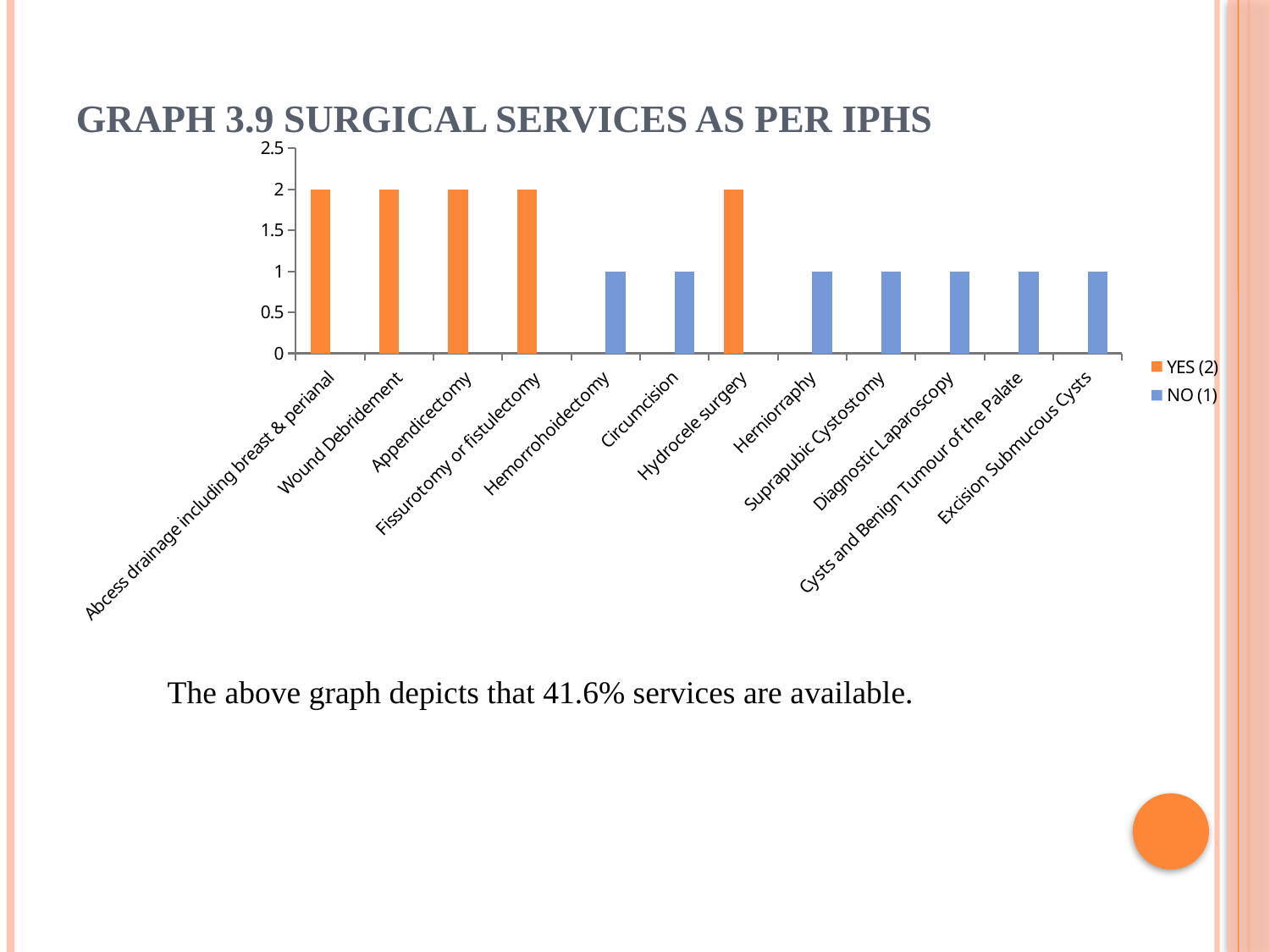
What is the difference between the value for Fissurotomy or fistulectomy and the value for Suprapubic Cystostomy? 1 Which series in the legend is shown in orange? YES (2) Is the value for Excision Submucous Cysts greater or less than 1.5? less How many series does the legend list? 2 How many categories are shown on the x axis? 12 Which is larger, the value for Appendicectomy or the value for Herniorraphy? Appendicectomy What is the value for Hydrocele surgery? 2 What is the value for Wound Debridement? 2 What is the value for Diagnostic Laparoscopy? 1 What is the value for Circumcision? 1 What kind of chart is shown on the slide? Bar chart What is the title of the chart? GRAPH 3.9 SURGICAL SERVICES AS PER IPHS